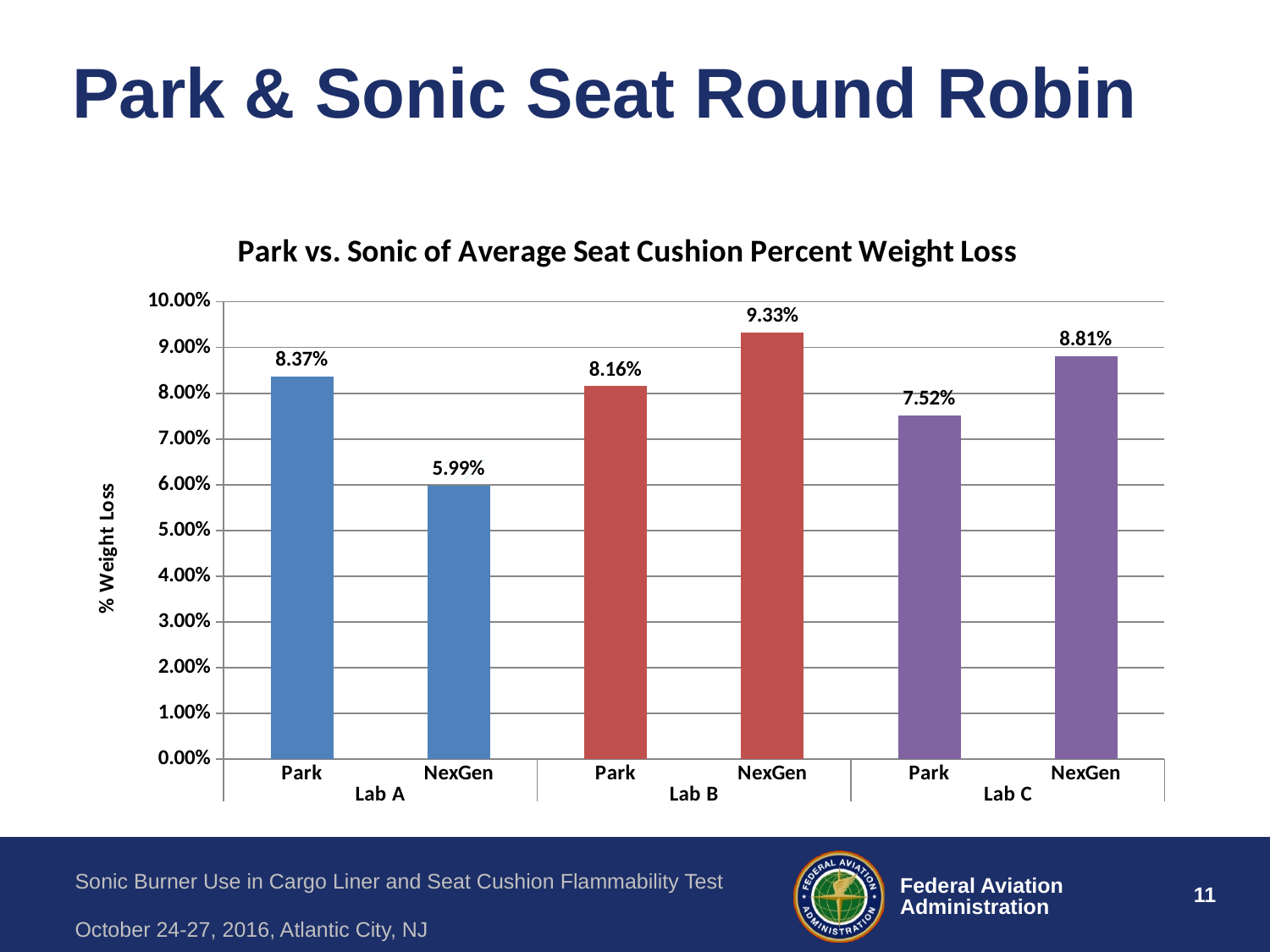
What is the value for NexGen in Lab B? 9.33% What is the title of the chart? Park vs. Sonic of Average Seat Cushion Percent Weight Loss What kind of chart is shown? Bar chart What is the difference between NexGen and Park in Lab C? 1.29% How many bars are plotted in the chart? 6 Which bar has the highest value? NexGen, Lab B What is the difference between Park and NexGen in Lab A? 2.38% Which bar has the lowest value? NexGen, Lab A What is the value for NexGen in Lab A? 5.99% What is the value for Park in Lab A? 8.37% Which is larger, Park in Lab B or NexGen in Lab B? NexGen in Lab B What is the value for Park in Lab C? 7.52%